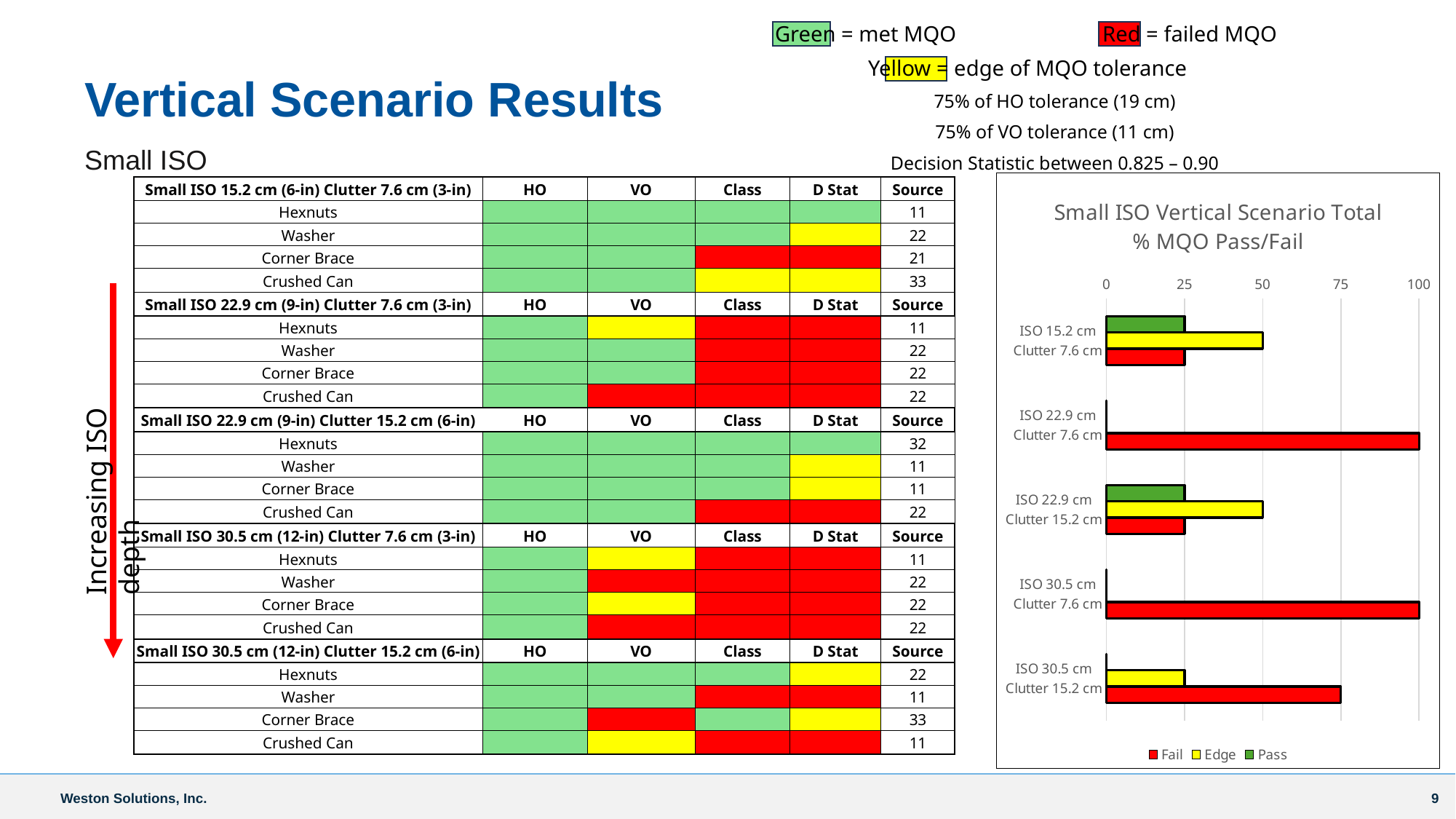
What is the Fail value for ISO 30.5 cm Clutter 15.2 cm? 75 What is the Pass value for ISO 22.9 cm Clutter 15.2 cm? 25 What kind of chart is shown on the slide? bar chart How many categories are shown on the chart's vertical axis? 5 Which series is shown in red in the chart? Fail Is the Fail value for ISO 30.5 cm Clutter 7.6 cm larger or smaller than the Fail value for ISO 30.5 cm Clutter 15.2 cm? larger What is the Fail value for ISO 22.9 cm Clutter 7.6 cm? 100 What is the Edge value for ISO 15.2 cm Clutter 7.6 cm? 50 Which category has the lowest Fail value? ISO 15.2 cm Clutter 7.6 cm and ISO 22.9 cm Clutter 15.2 cm (both 25) What is the difference between the Fail value for ISO 30.5 cm Clutter 15.2 cm and the Edge value for the same category? 50 How many series does the legend of the chart list? 3 What is the title of the chart? Small ISO Vertical Scenario Total % MQO Pass/Fail